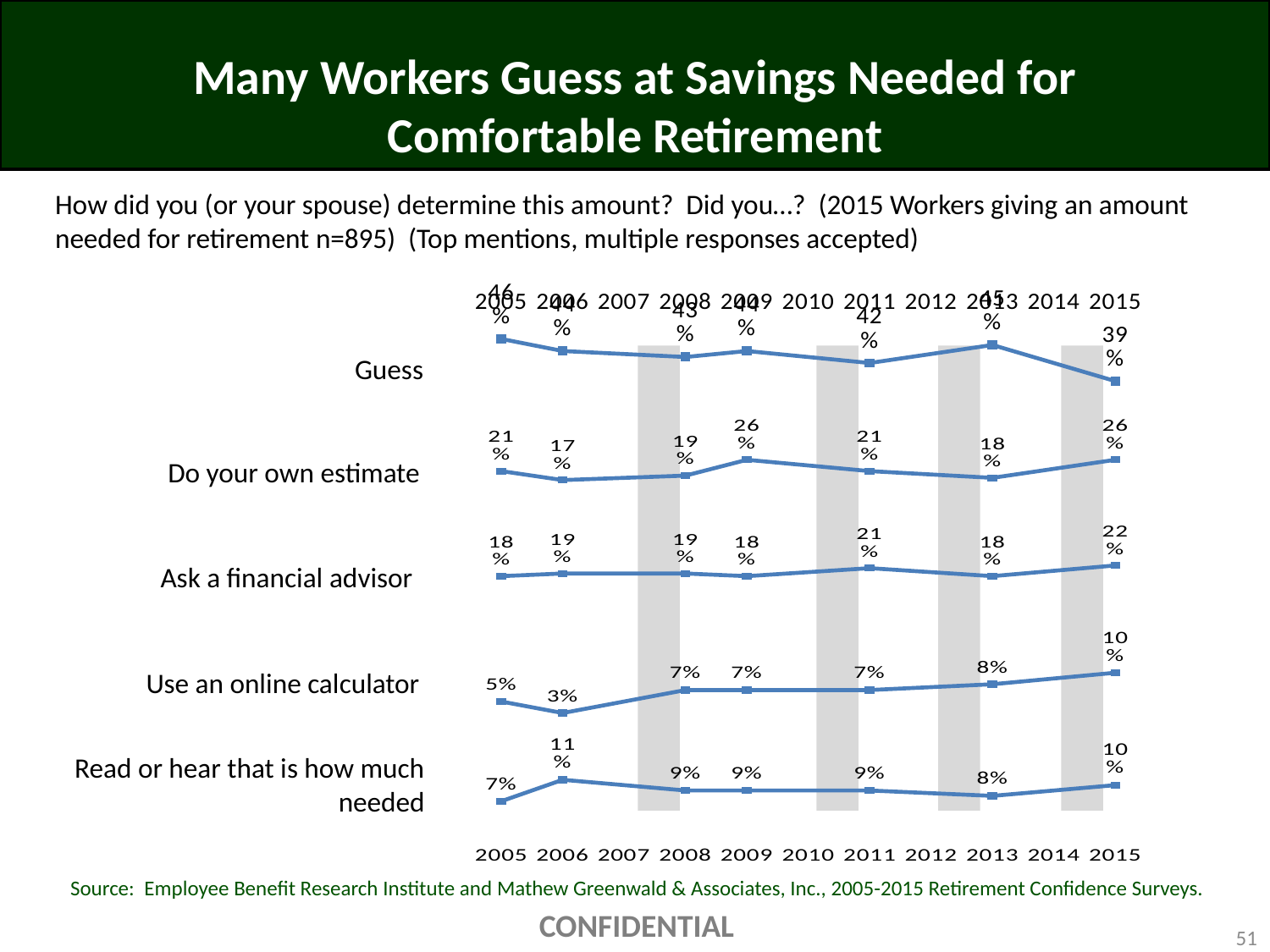
In the 'Do your own estimate' chart, what is the difference between the 2009 value and the 2006 value? 9% In the 'Use an online calculator' chart, what is the difference between the 2015 value and the 2005 value? 5% In the 'Guess' chart, what is the value for 2015? 39% What kind of chart is used to show each response category on this slide? Line chart In the 'Use an online calculator' chart, which year has the highest value? 2015 In the 'Use an online calculator' chart, which year has the lowest value? 2006 In the 'Ask a financial advisor' chart, what is the value for 2015? 22% In the 'Read or hear that is how much needed' chart, what is the value for 2006? 11% In the 'Use an online calculator' chart, do the values generally rise or fall from 2006 to 2015? Rise In the 'Do your own estimate' chart, what is the value for 2009? 26% In the 'Use an online calculator' chart, what is the value for 2006? 3% In the 'Ask a financial advisor' chart, which is larger, the value for 2011 or the value for 2013? 2011